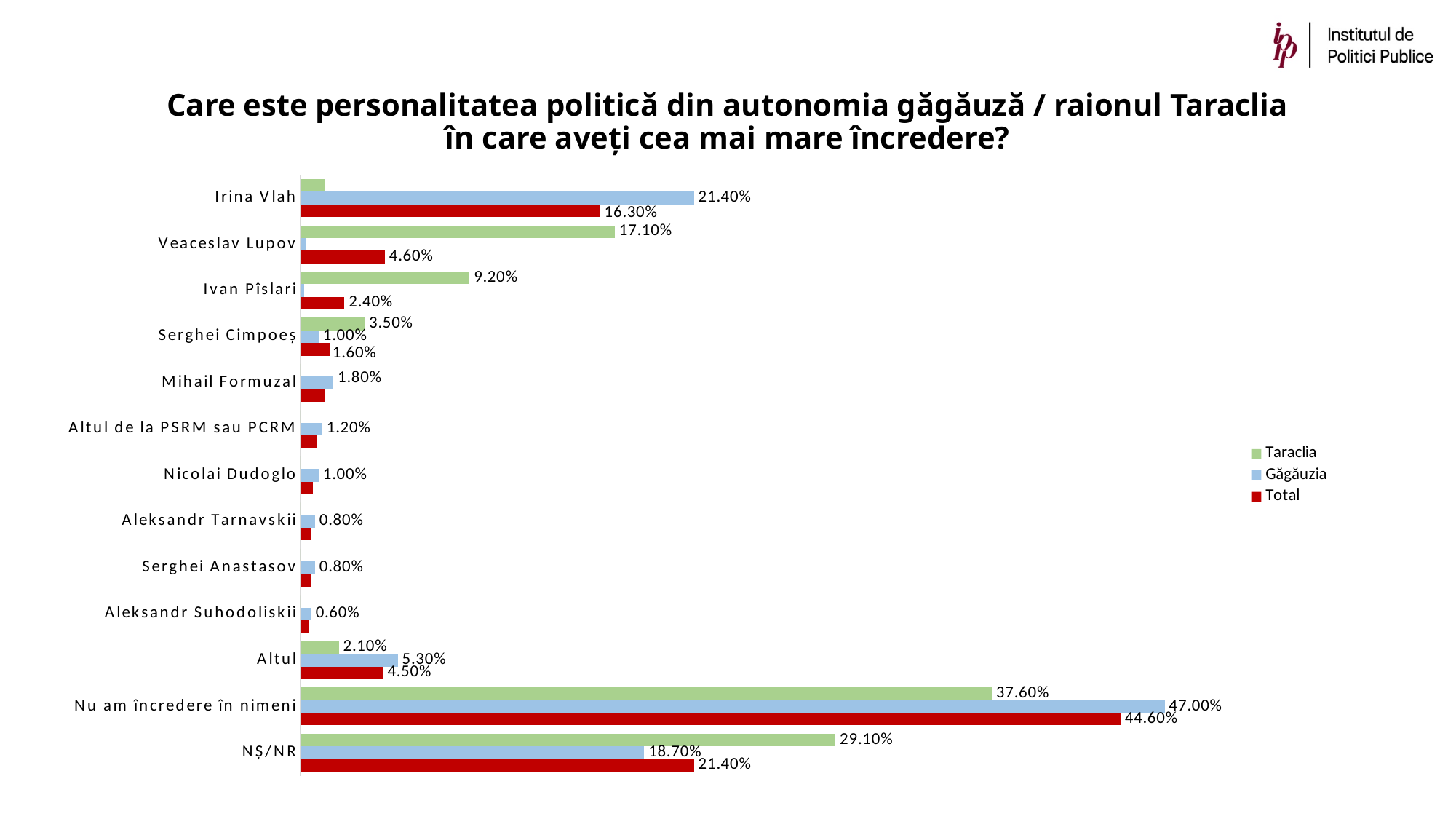
What is the Găgăuzia value for Irina Vlah? 21.40% What kind of chart is shown on the slide? Bar chart How many series does the legend list? 3 What is the Taraclia value for Veaceslav Lupov? 17.10% Which named politician has the highest Taraclia value? Veaceslav Lupov What is the difference between the Taraclia and Găgăuzia values for NȘ/NR? 10.40% What is the Total value for Nu am încredere în nimeni? 44.60% What is the difference between the Găgăuzia and Total values for Irina Vlah? 5.10% How many categories are shown on the chart? 13 Which is larger for Altul: the Găgăuzia value or the Total value? Găgăuzia Which category has the highest Găgăuzia value? Nu am încredere în nimeni What is the Găgăuzia value for NȘ/NR? 18.70%